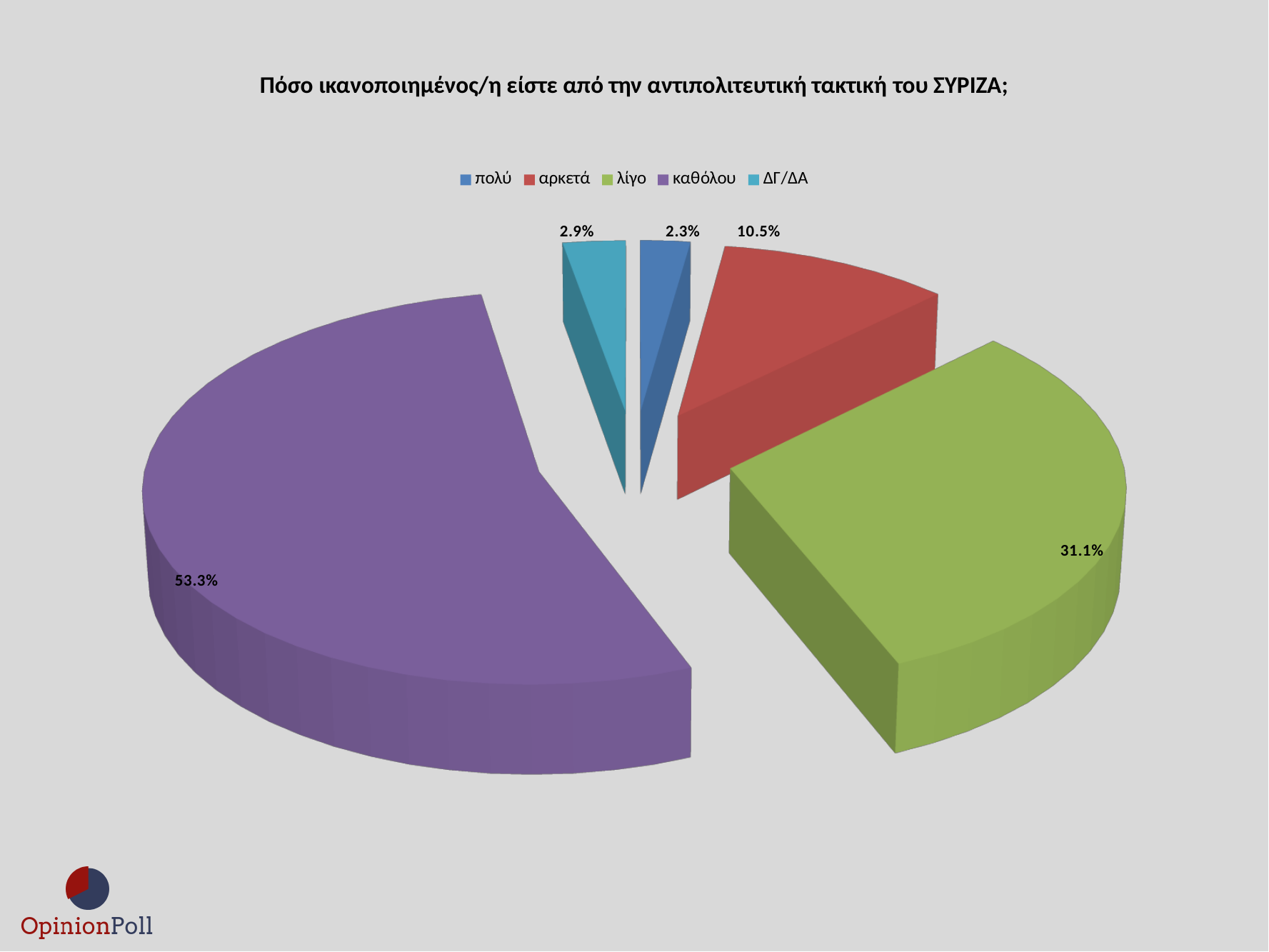
What is the value for πολύ? 2.3% What colour is the slice for λίγο? Green What is the value for ΔΓ/ΔΑ? 2.9% What is the value for λίγο? 31.1% What is the difference between the values for καθόλου and λίγο? 22.2% Which category has the largest share of the pie? καθόλου What type of chart is shown on the slide? Pie chart What is the value for αρκετά? 10.5% Which category has the smallest share of the pie? πολύ Which is larger, the value for αρκετά or the value for ΔΓ/ΔΑ? αρκετά What is the value for καθόλου? 53.3% How many categories does the legend list? 5